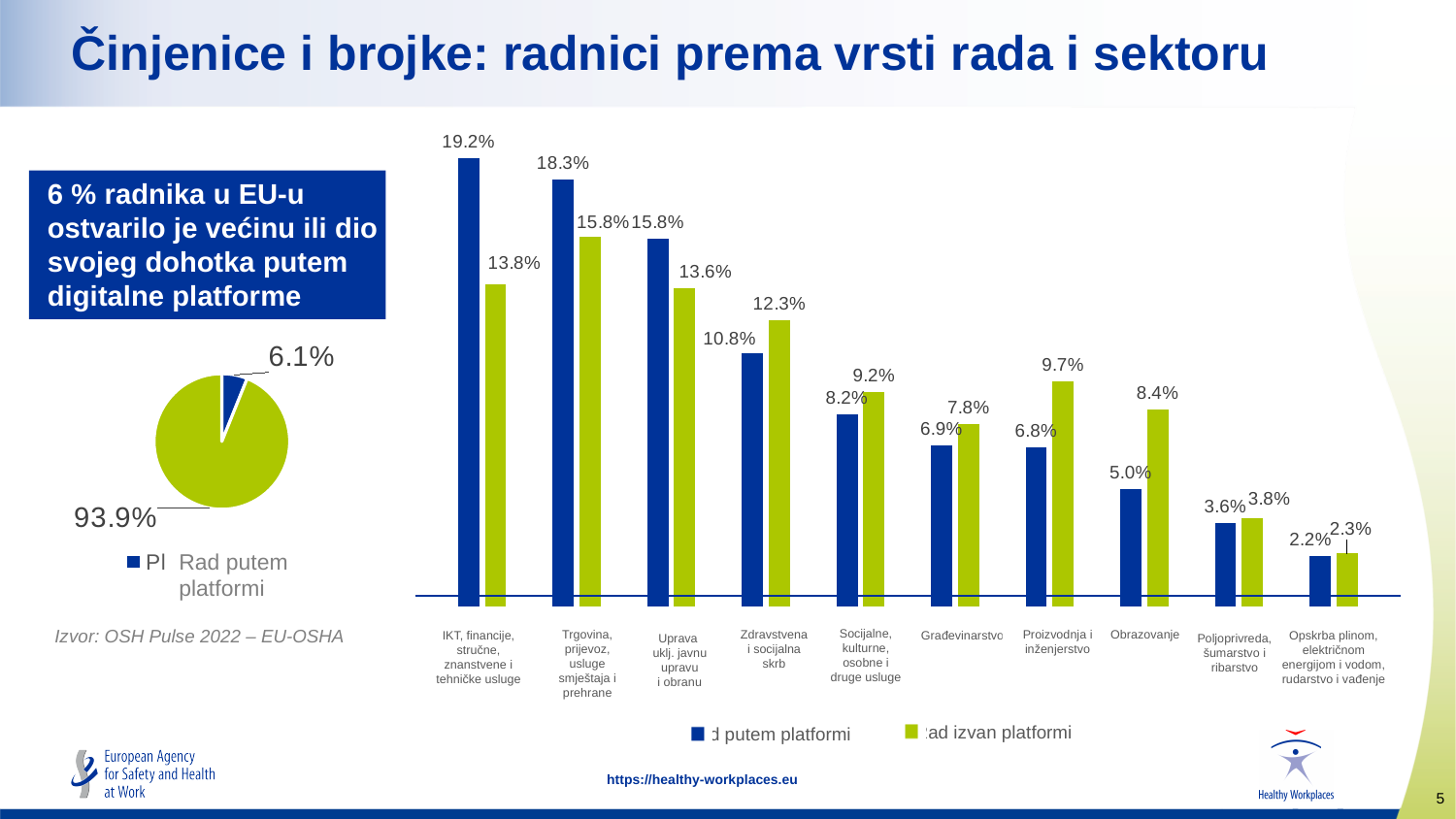
In the bar chart on the right, which category has the lowest green bar? Opskrba plinom, električnom energijom i vodom, rudarstvo i vađenje How many series does the legend of the bar chart on the right list? 2 In the bar chart on the right, which category has the highest blue bar? IKT, financije, stručne, znanstvene i tehničke usluge How many categories are shown on the x axis of the bar chart on the right? 10 In the bar chart on the right, what is the value of the blue bar for Obrazovanje? 5.0% In the bar chart on the right, what is the value of the green bar for Proizvodnja i inženjerstvo? 9.7% In the pie chart on the left, what is the value of the larger slice? 93.9% In the bar chart on the right, what is the value of the blue bar for Građevinarstvo? 6.9% What kind of chart is shown on the left side of the slide? pie chart In the bar chart on the right, for Obrazovanje, which is larger: the blue bar or the green bar? the green bar In the pie chart on the left, what is the value of the smaller (blue) slice? 6.1% In the bar chart on the right, what is the difference between the blue and green bars for Zdravstvena i socijalna skrb? 1.5%